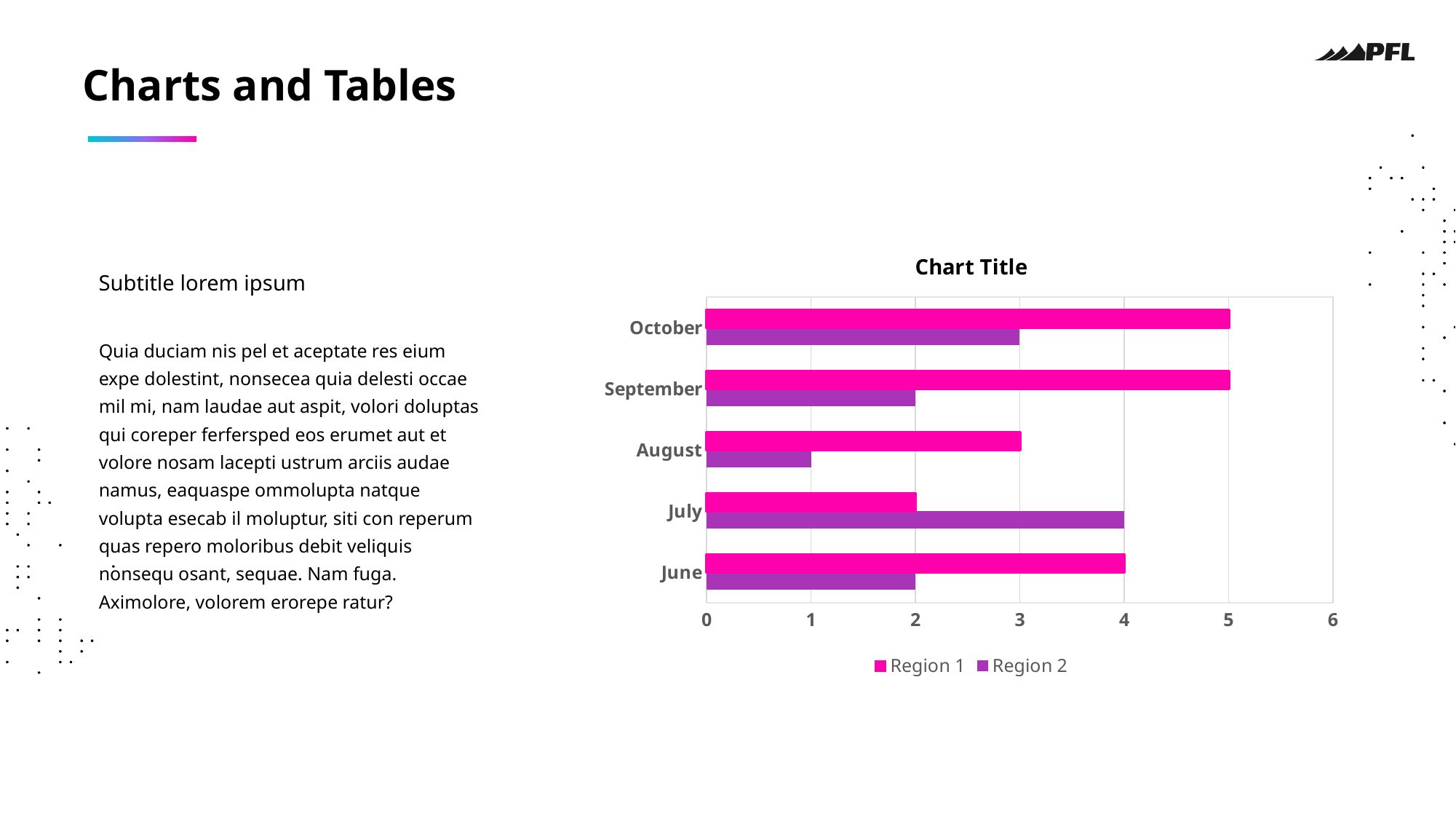
What is the value for Region 1 in June? 4 What is the value for Region 2 in August? 1 In July, which is larger, Region 1 or Region 2? Region 2 How many series does the legend list? 2 What is the value for Region 2 in July? 4 Which category has the lowest value for Region 2? August What is the value for Region 1 in September? 5 What kind of chart is shown on the slide? bar chart How many categories are shown on the chart? 5 What is the difference between Region 1 and Region 2 in October? 2 What is the title of the chart? Chart Title Which category has the highest value for Region 2? July